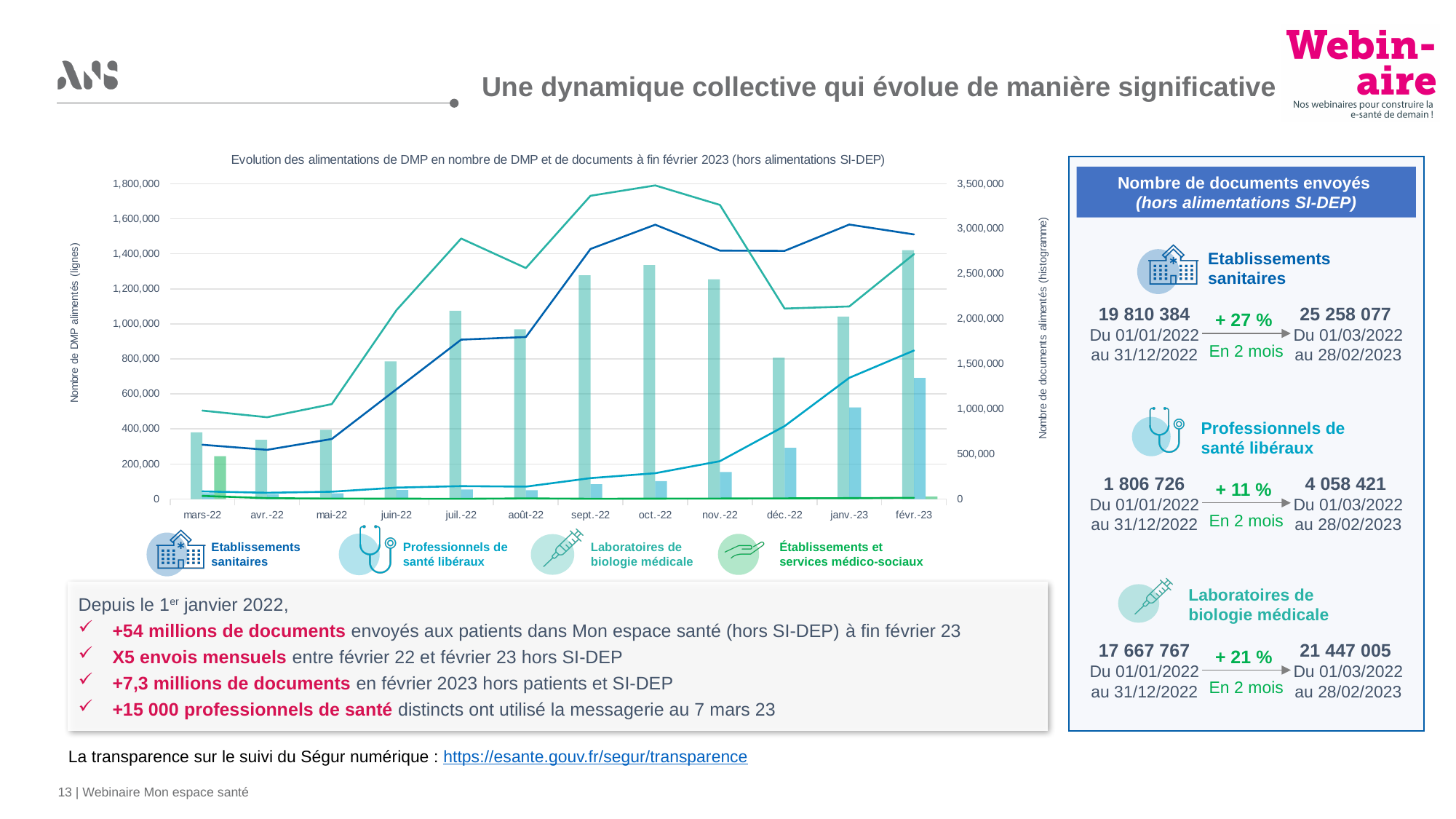
How many months are shown along the x axis of the chart? 12 What kind of chart is shown on the slide? Combined bar and line chart What is the title of the chart on the slide? Evolution des alimentations de DMP en nombre de DMP et de documents à fin février 2023 (hors alimentations SI-DEP) In which month does the Laboratoires de biologie médicale bar reach its highest value? févr.-23 What is the label of the left vertical axis of the chart? Nombre de DMP alimentés (lignes) Is the Laboratoires de biologie médicale bar for févr.-23 greater or less than 2,500,000 on the right axis? greater How many series does the chart legend list? 4 Does the Etablissements sanitaires line rise or fall between mars-22 and oct.-22? rise Is the Etablissements sanitaires line value for mars-22 greater or less than 400,000 on the left axis? less In oct.-22, which line is higher: Laboratoires de biologie médicale or Etablissements sanitaires? Laboratoires de biologie médicale Is the Laboratoires de biologie médicale line value for oct.-22 greater or less than 1,600,000 on the left axis? greater